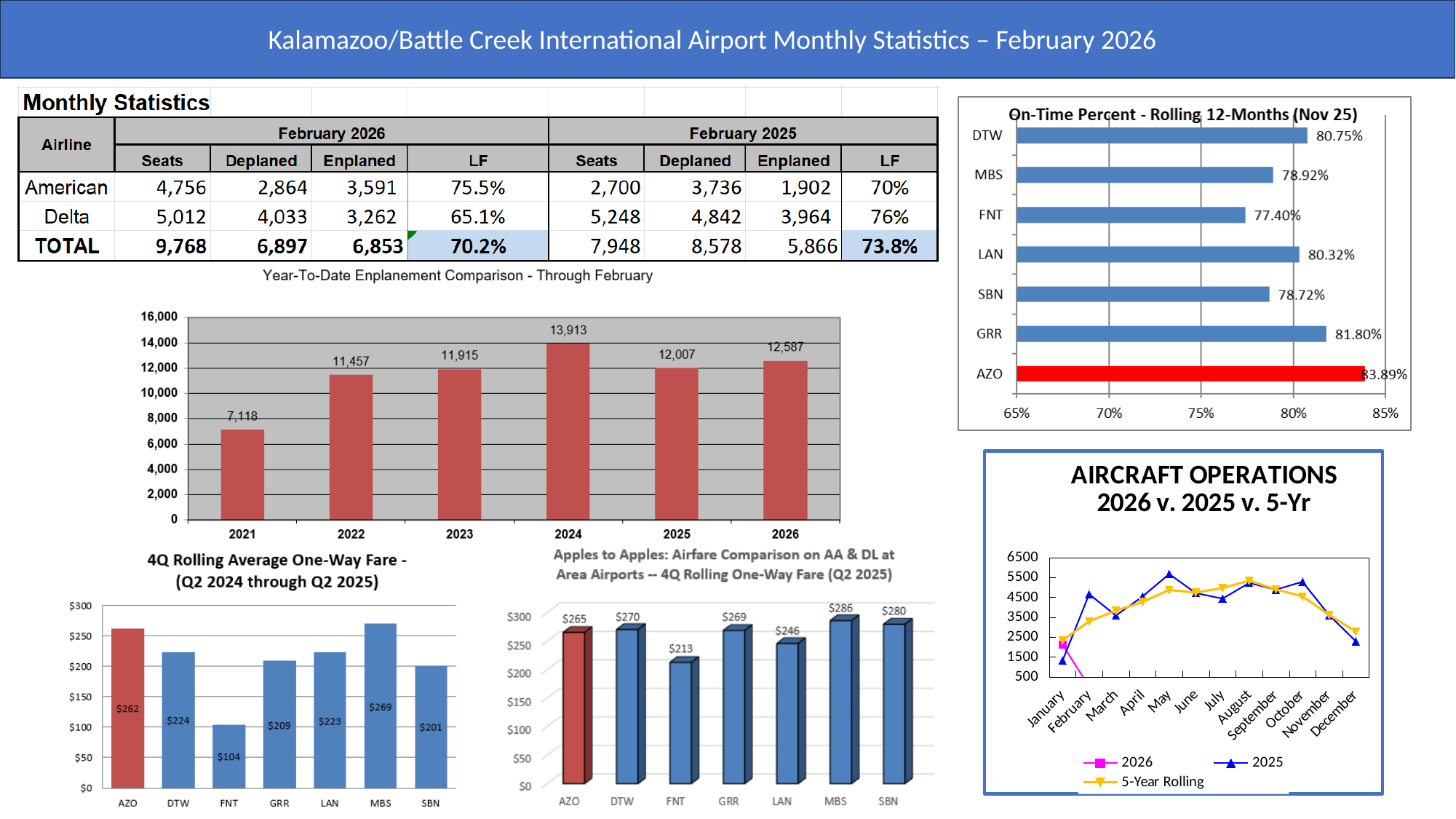
In the Year-To-Date Enplanement Comparison chart, what is the difference between the 2026 and 2025 values? 580 In the Year-To-Date Enplanement Comparison chart, what is the value for 2024? 13,913 In the Year-To-Date Enplanement Comparison chart, which year has the highest value? 2024 In the 4Q Rolling Average One-Way Fare chart, what is the value for FNT? $104 In the Apples to Apples Airfare Comparison chart, what is the difference between the MBS and FNT fares? $73 How many series does the legend of the Aircraft Operations chart list? 3 How many airports are shown in the On-Time Percent - Rolling 12-Months chart? 7 In the Year-To-Date Enplanement Comparison chart, which year has the lowest value? 2021 In the Apples to Apples Airfare Comparison chart, which is larger, the fare for AZO or for DTW? DTW In the On-Time Percent - Rolling 12-Months chart, what is the value for AZO? 83.89% In the 4Q Rolling Average One-Way Fare chart, which airport has the highest fare? MBS In the On-Time Percent - Rolling 12-Months chart, which airport has the lowest on-time percent? FNT